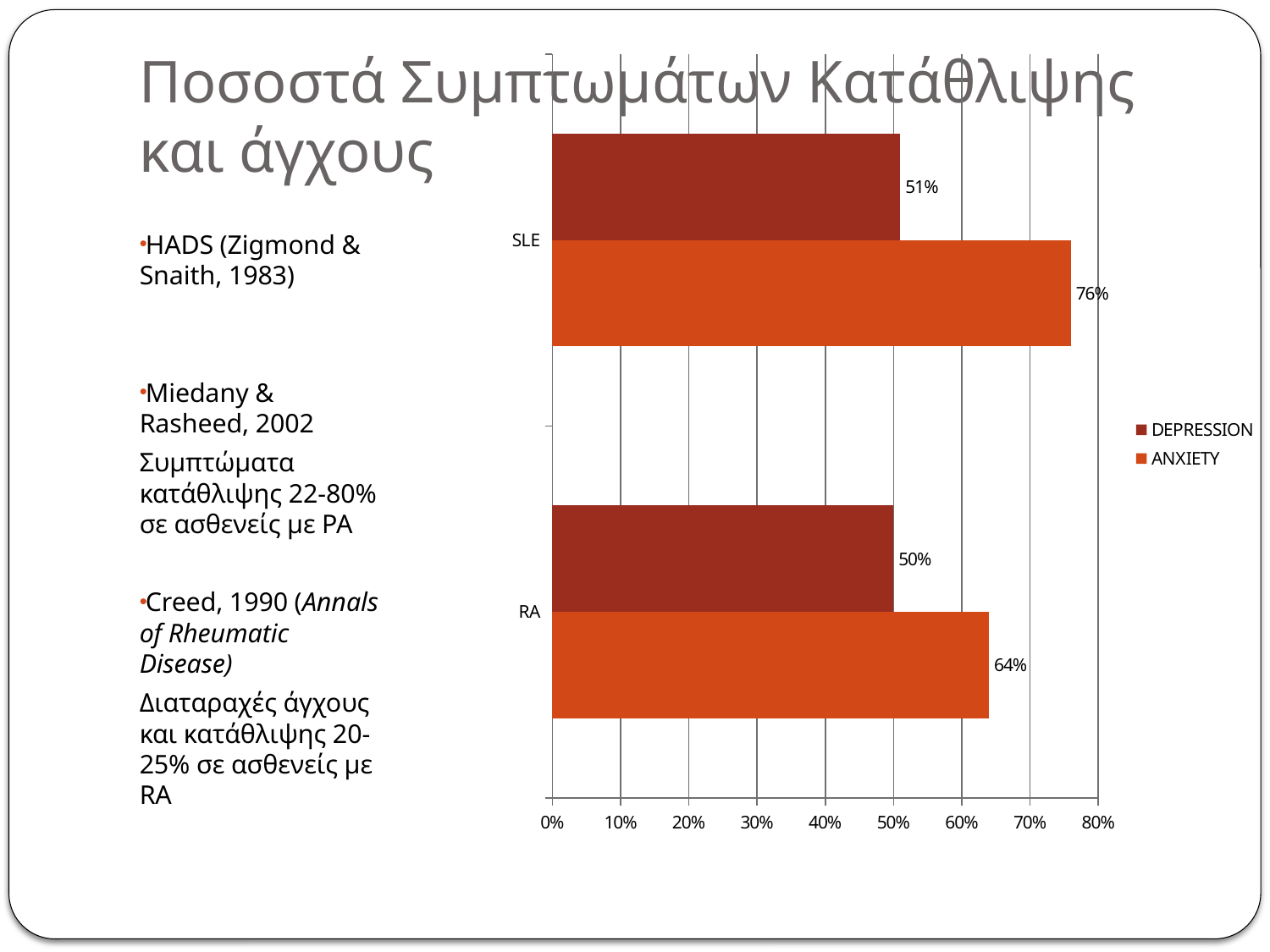
Which is larger for RA: the ANXIETY value or the DEPRESSION value? ANXIETY Which category has the lowest DEPRESSION value? RA Which category has the highest ANXIETY value? SLE What is the DEPRESSION value for RA? 50% What is the ANXIETY value for SLE? 76% What is the difference between the ANXIETY values for SLE and RA? 12% How many series does the legend list? 2 Is the ANXIETY value for SLE greater or less than 70%? greater How many categories are shown on the chart? 2 What kind of chart is shown on the slide? bar chart What is the DEPRESSION value for SLE? 51% What is the ANXIETY value for RA? 64%